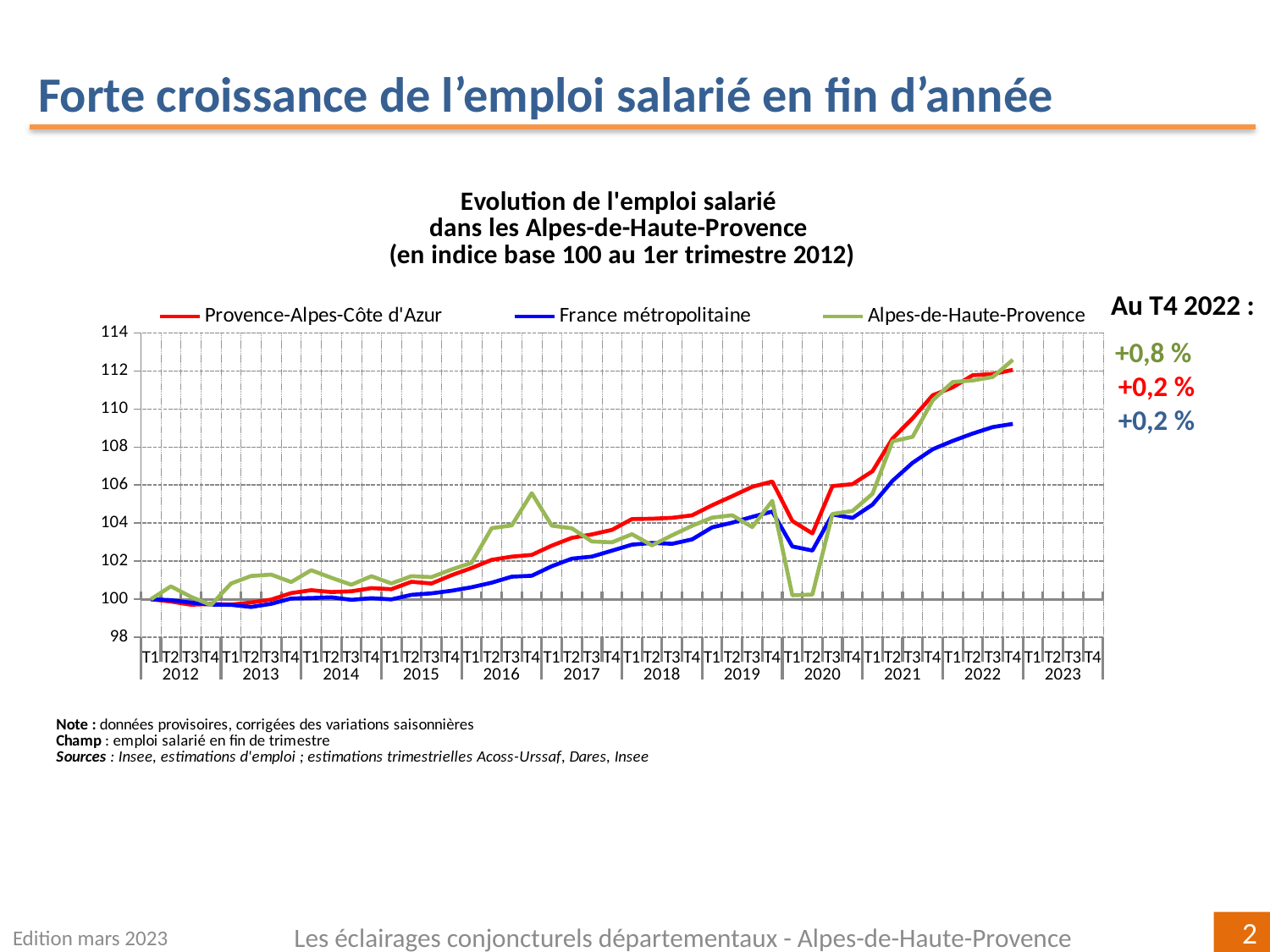
What growth rate is shown for Alpes-de-Haute-Provence at T4 2022? +0,8 % Is the value for Alpes-de-Haute-Provence at T2 2020 greater or less than 102? less What growth rate is shown for France métropolitaine at T4 2022? +0,2 % At T2 2020, which is higher: France métropolitaine or Alpes-de-Haute-Provence? France métropolitaine At T4 2022, which is higher: Provence-Alpes-Côte d'Azur or France métropolitaine? Provence-Alpes-Côte d'Azur What is the title of the chart? Evolution de l'emploi salarié dans les Alpes-de-Haute-Provence (en indice base 100 au 1er trimestre 2012) Is the value for France métropolitaine at T4 2022 greater or less than 110? less Which series is drawn in green? Alpes-de-Haute-Provence Overall, does the France métropolitaine series rise or fall from 2012 to 2022? rise What kind of chart is shown on the slide? line chart Is the value for Alpes-de-Haute-Provence at T4 2016 greater or less than 104? greater How many series does the legend list? 3